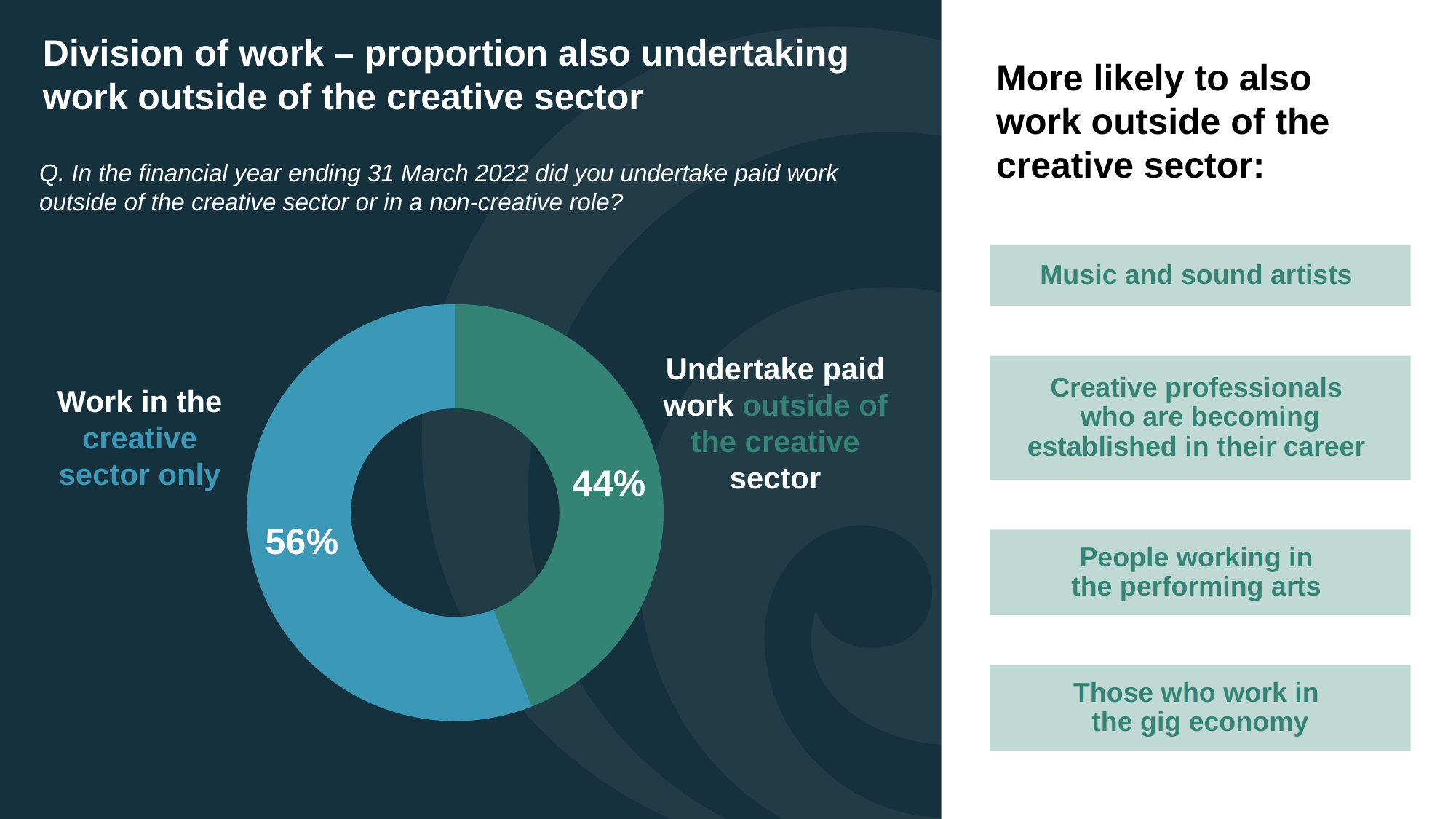
What kind of chart is shown on the slide? Pie chart (doughnut) Which category has the smallest share in the chart? Undertake paid work outside of the creative sector What percentage of respondents undertake paid work outside of the creative sector? 44% Which category has the larger share: work in the creative sector only, or undertake paid work outside of the creative sector? Work in the creative sector only What is the total of the two percentages shown in the chart? 100% How many categories are shown in the chart? 2 Is the share of respondents who work in the creative sector only greater or less than 50%? greater What percentage of respondents work in the creative sector only? 56% What is the difference in percentage points between the share working in the creative sector only and the share undertaking paid work outside of the creative sector? 12 What colour is the slice representing those who work in the creative sector only? Blue What is the title of the chart? Division of work – proportion also undertaking work outside of the creative sector